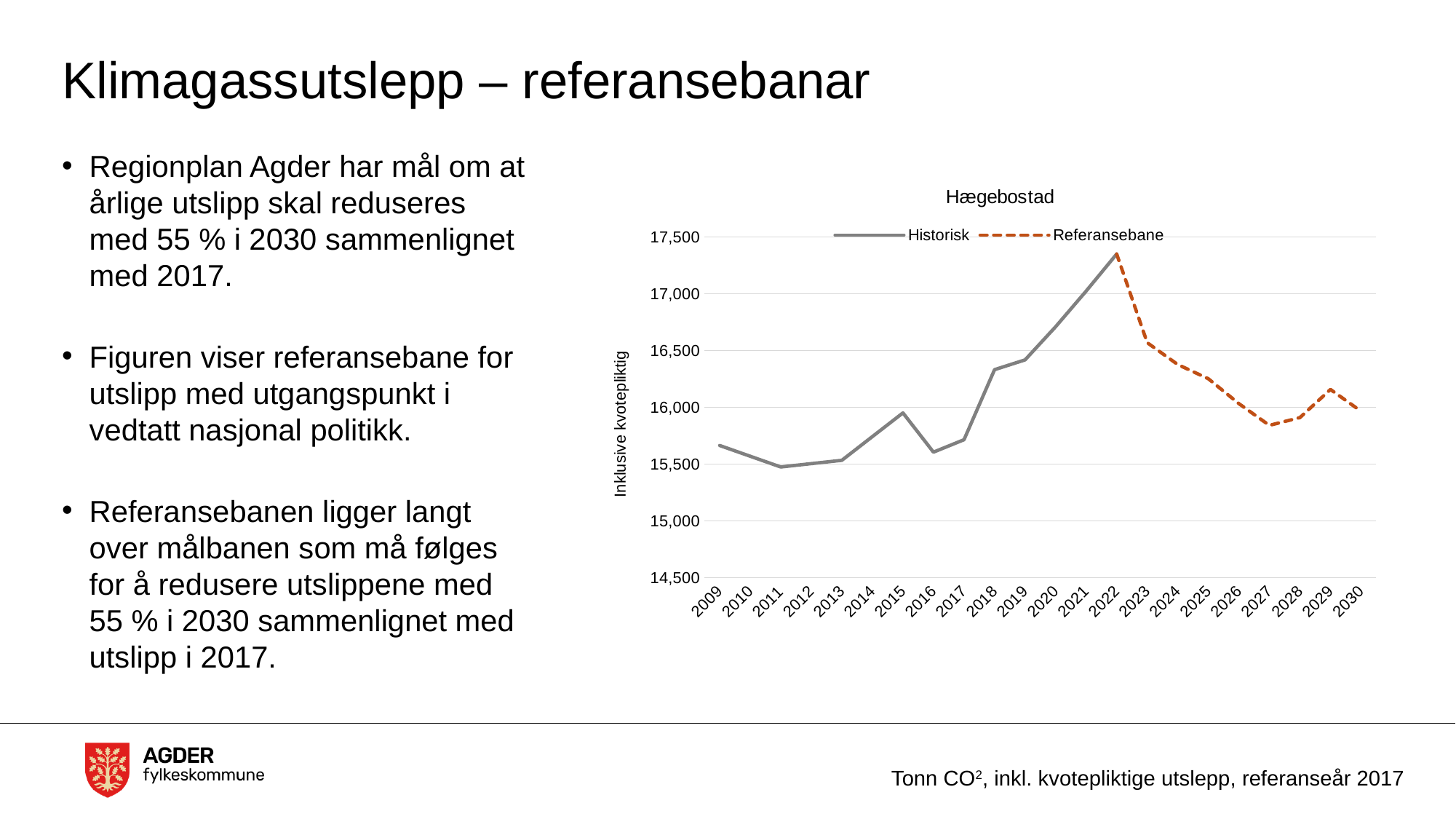
Does the Referansebane line rise or fall from 2022 to 2027? fall What kind of chart is shown on the slide? line chart Which is larger, the value for 2022 or the value for 2030? 2022 Is the value for 2022 greater or less than 17,000? greater In which year does the line reach its highest value? 2022 Is the value for 2030 greater or less than 16,500? less How many years are shown on the x axis of the chart? 22 How many series does the chart legend list? 2 Is the value for 2018 greater or less than 16,000? greater What are the two series named in the chart legend? Historisk and Referansebane What is the title of the chart? Hægebostad In which year does the Historisk line reach its lowest value? 2011